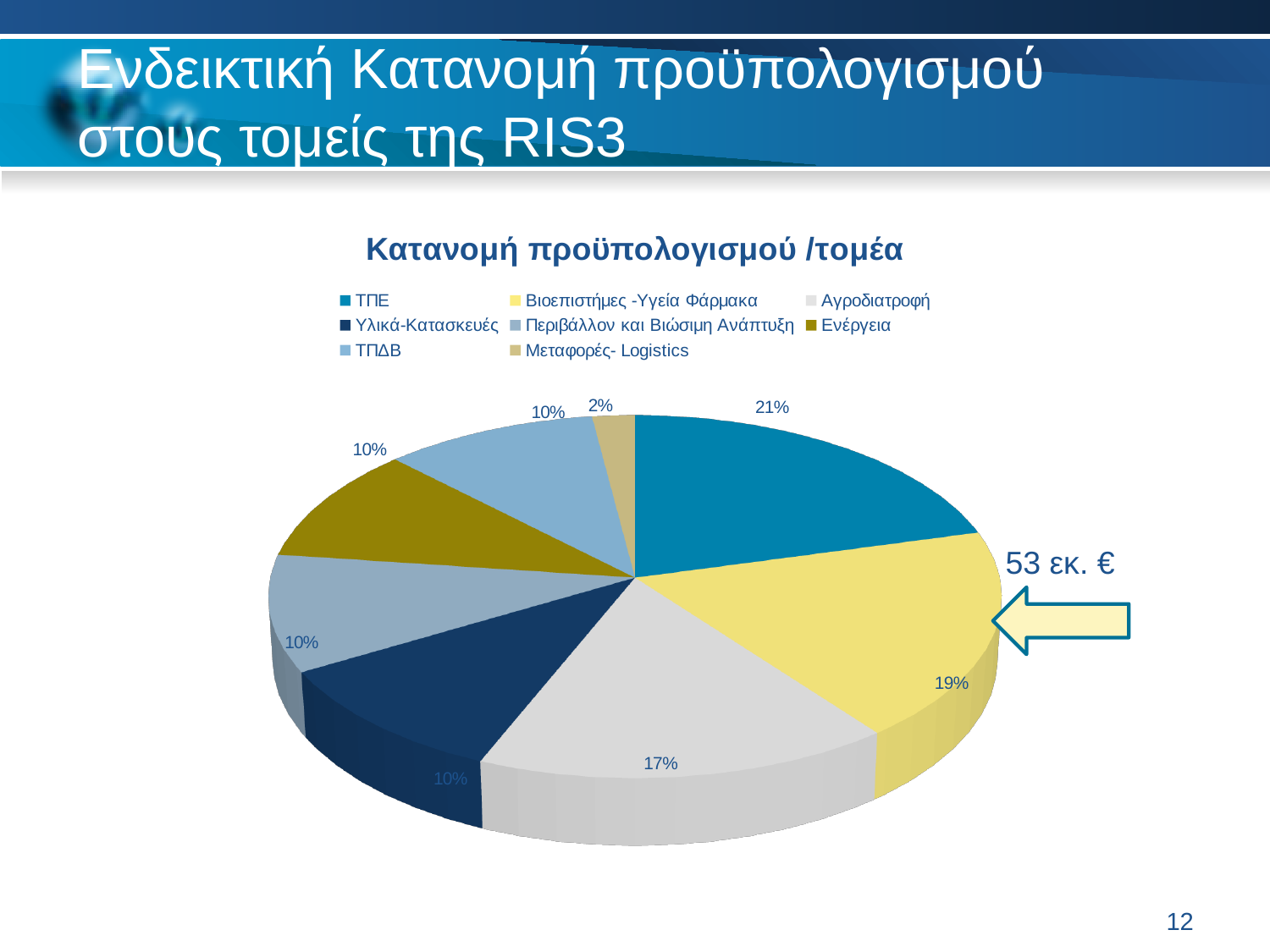
What amount is written next to the arrow pointing at the pie chart? 53 εκ. € Which sector has the smallest share of the budget? Μεταφορές- Logistics What is the title of the chart? Κατανομή προϋπολογισμού /τομέα What is the difference in percentage points between the ΤΠΕ share and the Αγροδιατροφή share? 4 percentage points What share of the budget goes to Βιοεπιστήμες -Υγεία Φάρμακα? 19% How many sectors (slices) does the pie chart show? 8 What share of the budget goes to Αγροδιατροφή? 17% What share of the budget goes to Μεταφορές- Logistics? 2% Which has a larger share, Βιοεπιστήμες -Υγεία Φάρμακα or Ενέργεια? Βιοεπιστήμες -Υγεία Φάρμακα What kind of chart is shown on the slide? Pie chart Which sector has the largest share of the budget? ΤΠΕ